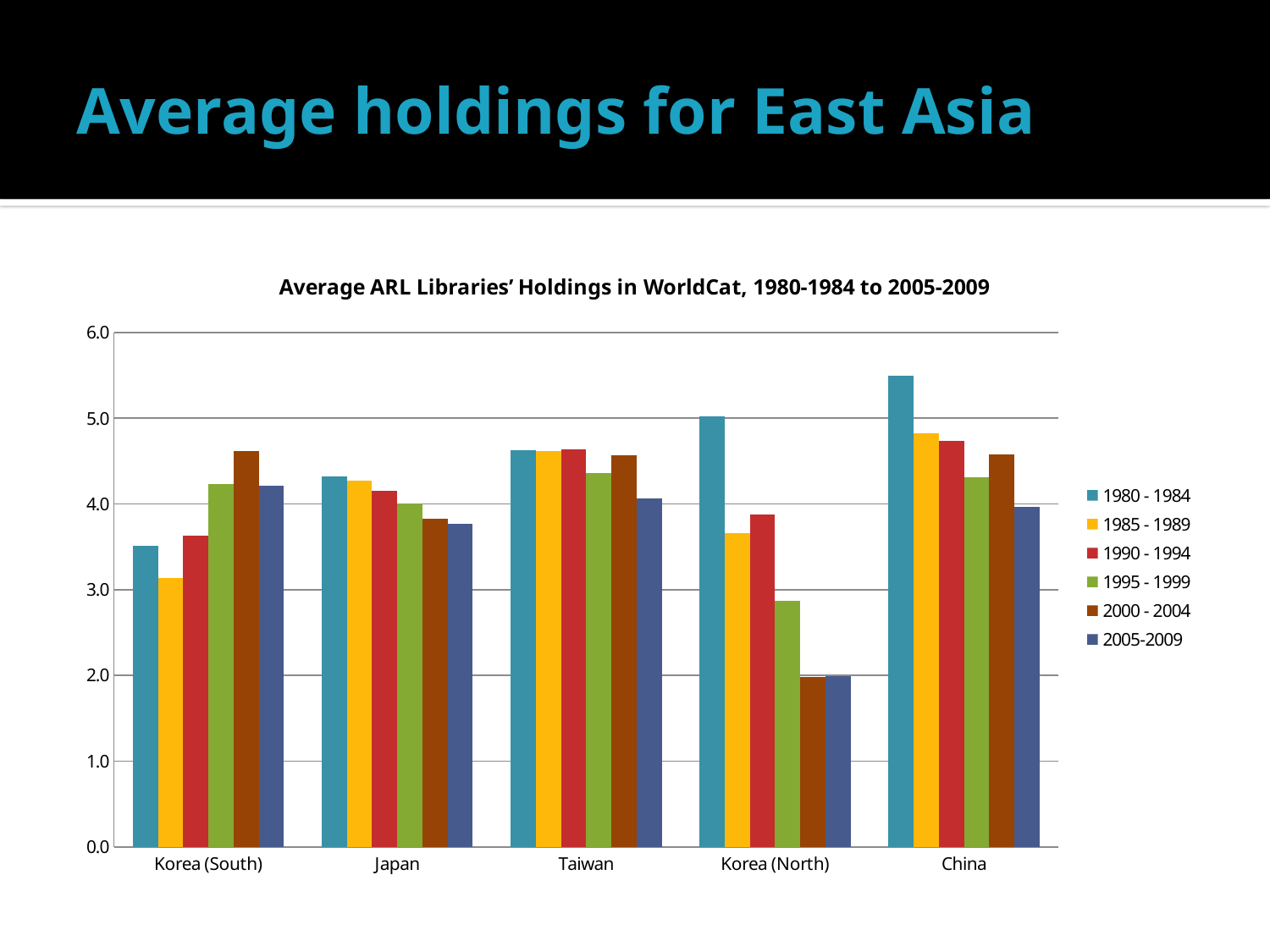
Is the value for Korea (North) in 2000 - 2004 greater or less than 3.0? less Do the values for Japan rise or fall from 1980 - 1984 to 2005-2009? fall Which country has the highest value for 1980 - 1984? China Which country has the lowest value for 2005-2009? Korea (North) How many countries are shown on the x axis? 5 Is the value for Korea (South) in 1985 - 1989 greater or less than 4.0? less What kind of chart is shown on the slide? bar chart For Korea (South), which is larger: the 1980 - 1984 value or the 2000 - 2004 value? 2000 - 2004 Which is larger for 1980 - 1984: Korea (North) or Japan? Korea (North) Is the value for China in 1980 - 1984 greater or less than 5.0? greater How many series does the legend list? 6 Which country has the lowest value for 1980 - 1984? Korea (South)